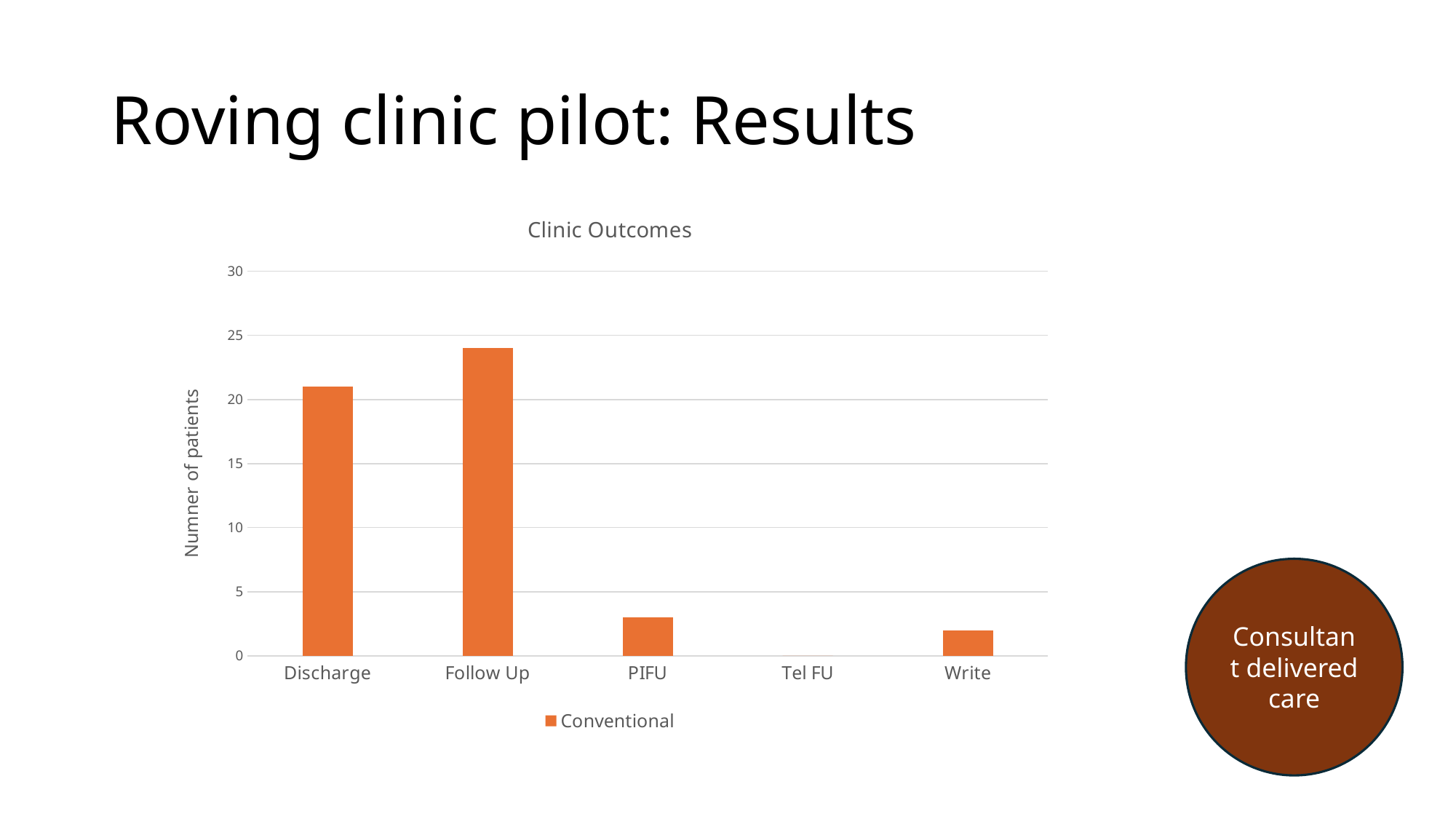
How many categories are shown on the x axis of the chart? 5 Which category has the highest number of patients? Follow Up How many series does the chart legend list? 1 Is the value for PIFU greater or less than 5? less What is the name of the series shown in the chart legend? Conventional Which has more patients, Discharge or Follow Up? Follow Up Which category has the lowest number of patients? Tel FU What is the title of the chart? Clinic Outcomes Is the value for Write greater or less than 5? less Is the value for Follow Up greater or less than 20? greater What type of chart is shown on the slide? bar chart